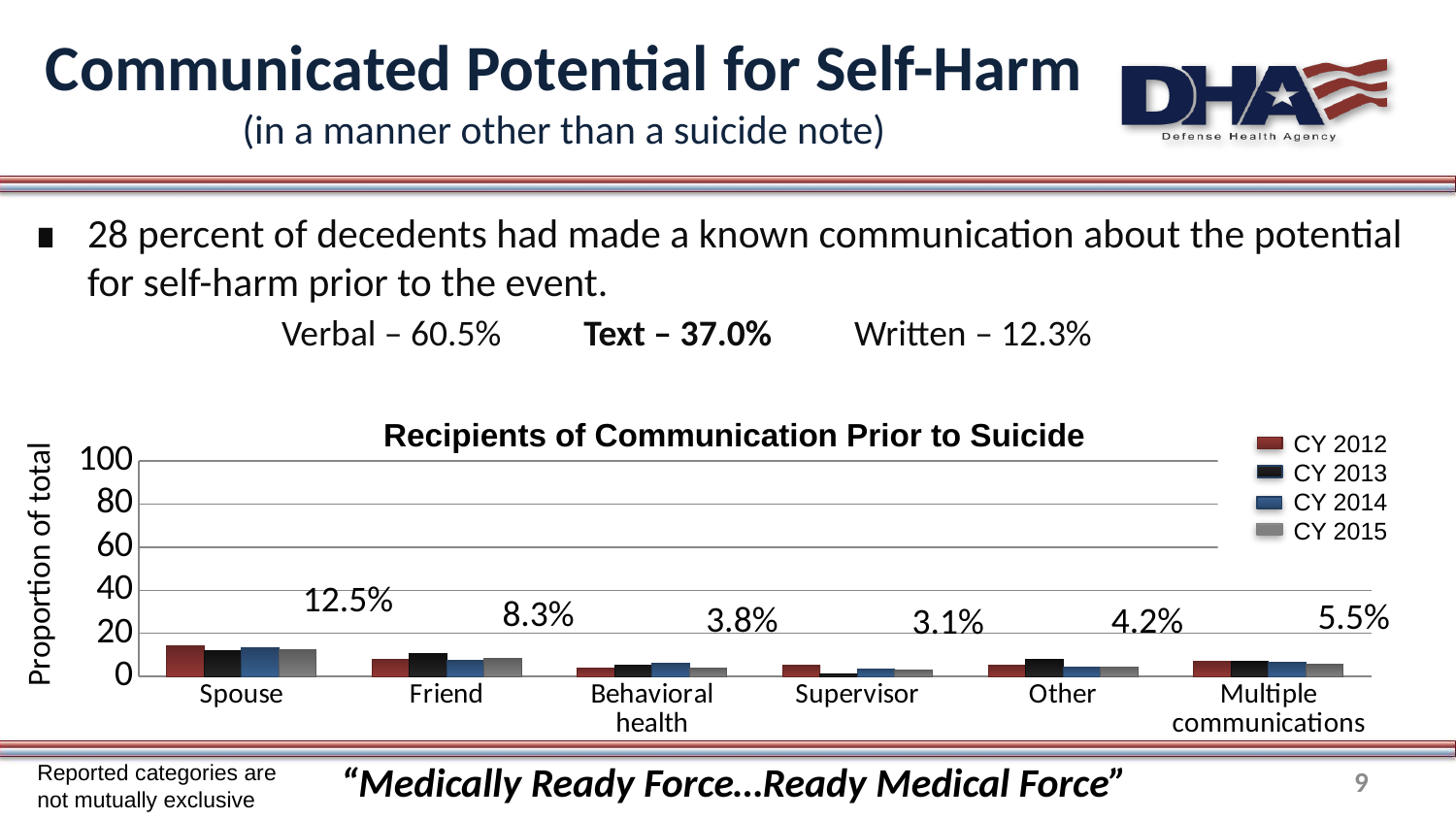
Which has the larger printed data label, Behavioral health or Other? Other How many series does the chart legend list? 4 What is the difference between the printed data labels for Spouse and Friend? 4.2% What kind of chart is shown on the slide? bar chart What data label is printed above the Spouse group in the chart? 12.5% Which category has the highest printed data label in the chart? Spouse What is the title of the chart? Recipients of Communication Prior to Suicide Is the CY 2012 value for Spouse greater or less than 20? less What data label is printed above the Supervisor group in the chart? 3.1% How many recipient categories are shown on the x axis of the chart? 6 Which category has the lowest printed data label in the chart? Supervisor What data label is printed above the Multiple communications group in the chart? 5.5%